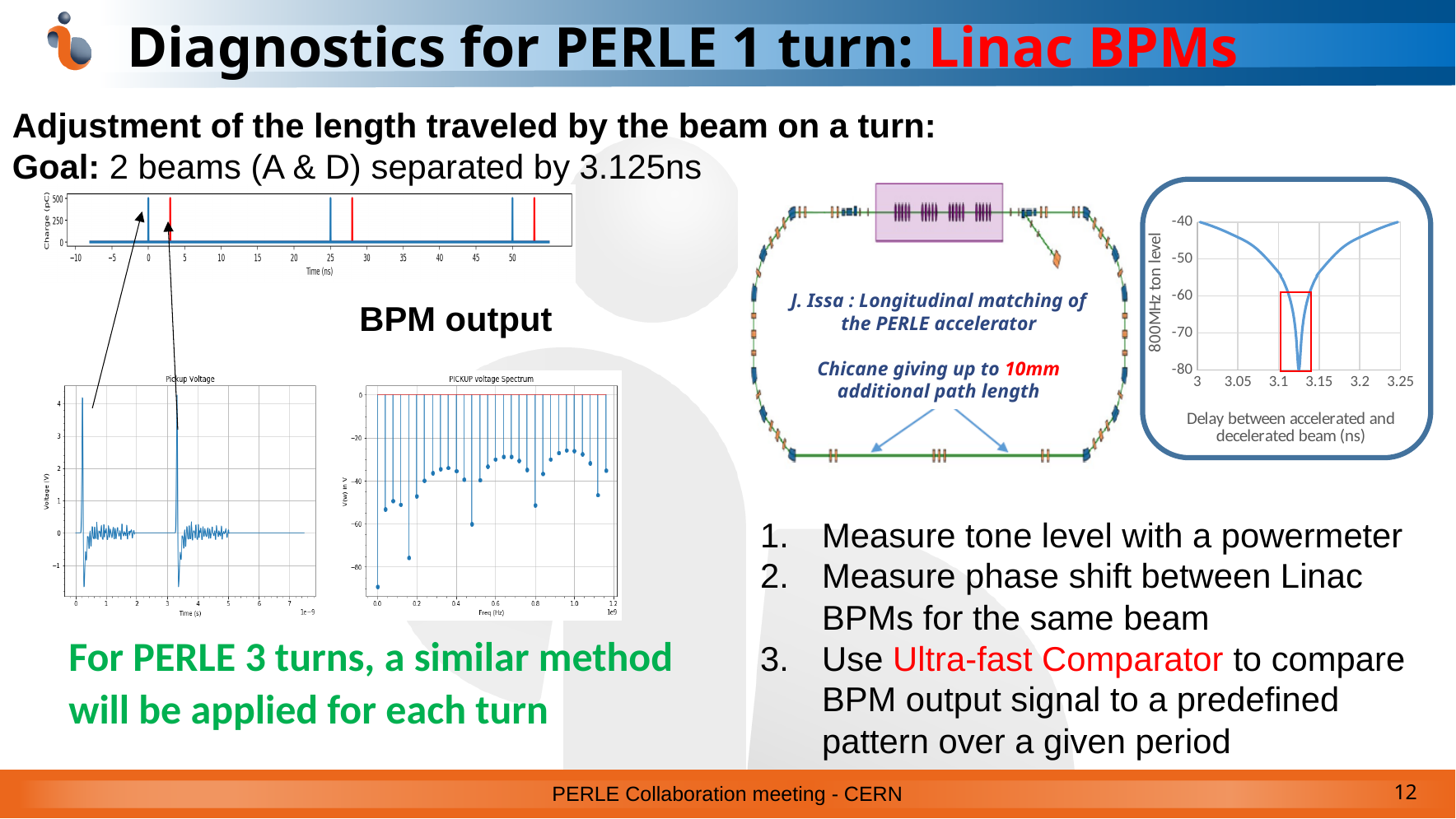
On the '800MHz ton level' chart, is the tone level at a delay of 3.25 greater or less than -50? greater On the 'Charge (pC)' versus 'Time (ns)' chart at the top left, is the height of the spikes greater or less than 250 pC? greater On the 'Charge (pC)' versus 'Time (ns)' chart at the top left, how many spikes are plotted in total (blue and red)? 6 On the 'Pickup Voltage' chart, how many large positive voltage spikes are shown? 2 On the '800MHz ton level' chart, what quantity is plotted on the x axis according to the caption below it? Delay between accelerated and decelerated beam (ns) On the '800MHz ton level' chart, does the tone level rise or fall as the delay increases from 3 to 3.1? fall What is the title of the voltage-versus-time chart at the bottom left of the slide? Pickup Voltage On the '800MHz ton level' chart, is the minimum tone level greater or less than -70? less What kind of chart is the '800MHz ton level' chart on the right of the slide? line chart On the '800MHz ton level' chart, does the tone level rise or fall as the delay increases from 3.15 to 3.25? rise